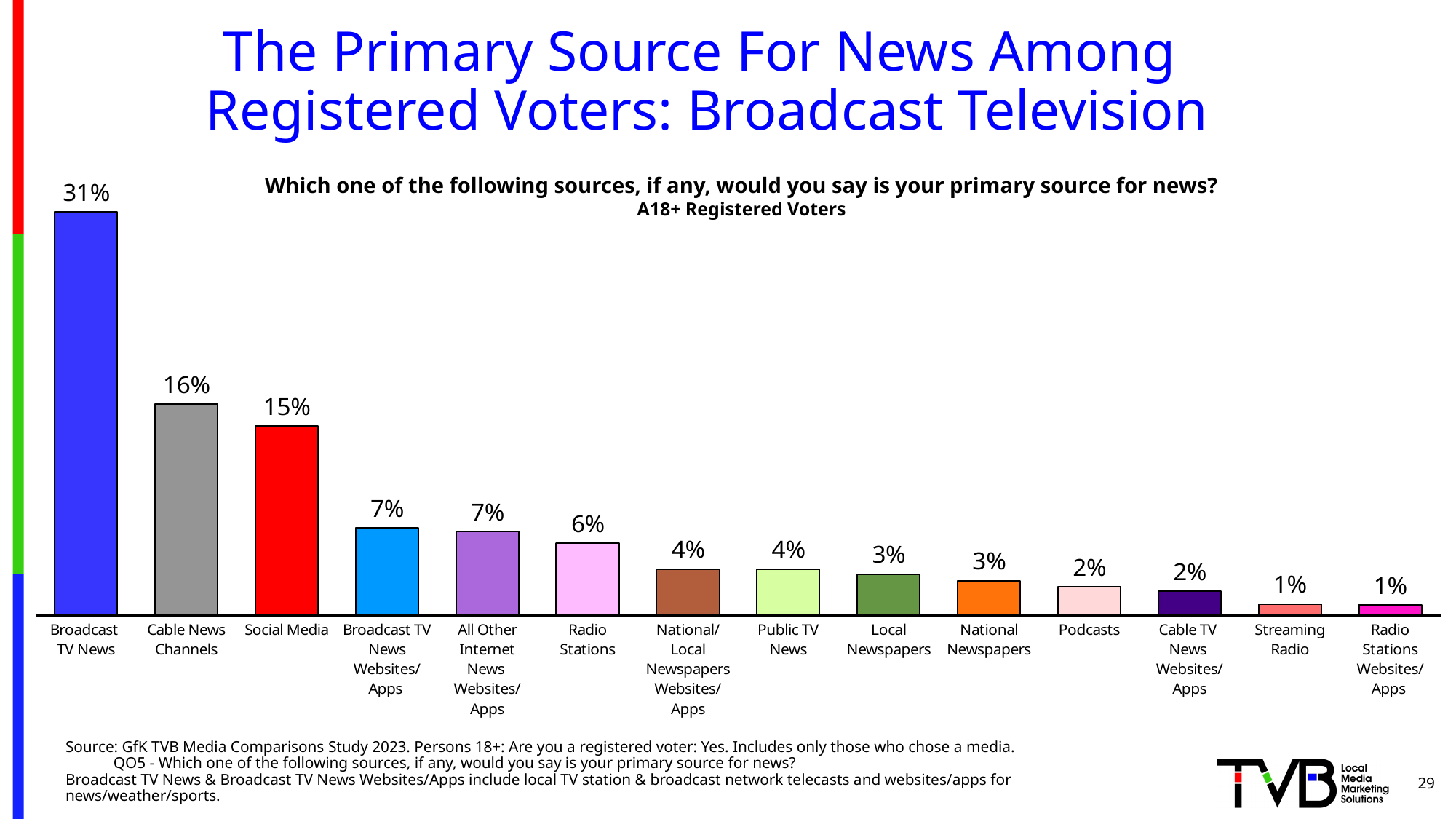
Which source has the highest value in the chart? Broadcast TV News What is the value shown for Social Media? 15% What kind of chart is shown on the slide? Bar chart What is the difference between the values for Cable News Channels and Social Media? 1% What percentage of registered voters named Broadcast TV News as their primary source for news? 31% How many news sources (categories) are shown in the chart? 14 Which is larger, the value for Radio Stations or the value for Public TV News? Radio Stations What is the value shown for Podcasts? 2% What survey question is shown as the chart's subtitle? Which one of the following sources, if any, would you say is your primary source for news? Do the values rise or fall moving from left to right across the chart? Fall What is the difference between the values for Broadcast TV News and Cable News Channels? 15% What is the value shown for Radio Stations? 6%